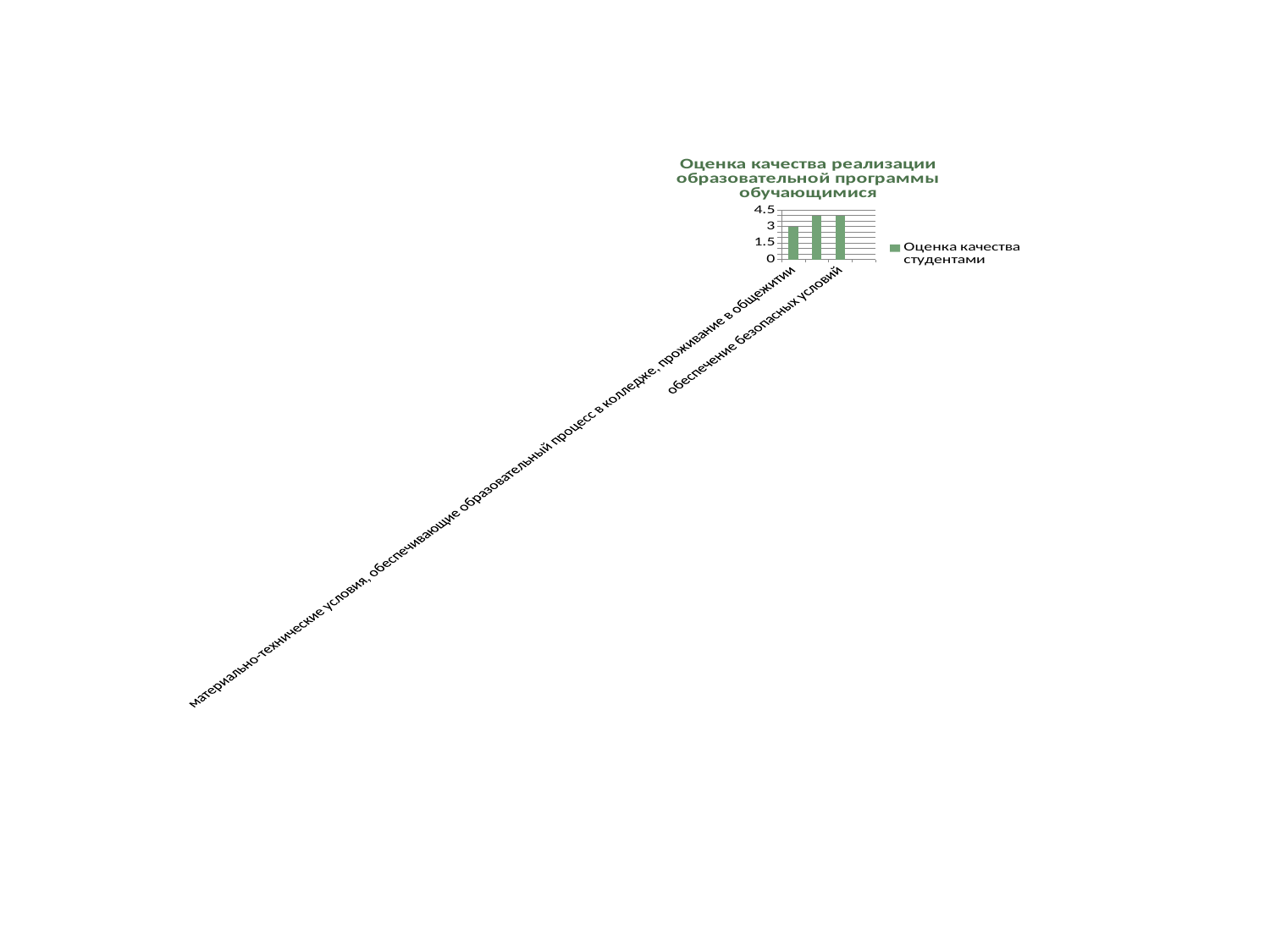
What is the title of the chart? Оценка качества реализации образовательной программы обучающимися Is the value for "обеспечение безопасных условий" greater or less than 3? greater What is the legend entry of the chart? Оценка качества студентами How many series does the chart legend list? 1 Which bar is the lowest: the leftmost, the middle or the rightmost? leftmost Is the value of the leftmost bar greater or less than 1.5? greater Is the value for "обеспечение безопасных условий" greater or less than 4.5? less What is the highest tick value shown on the vertical axis? 4.5 Which is larger: the leftmost bar or the rightmost bar ("обеспечение безопасных условий")? the rightmost bar (обеспечение безопасных условий) How many bars (categories) does the chart show? 3 What kind of chart is shown on the slide? bar chart